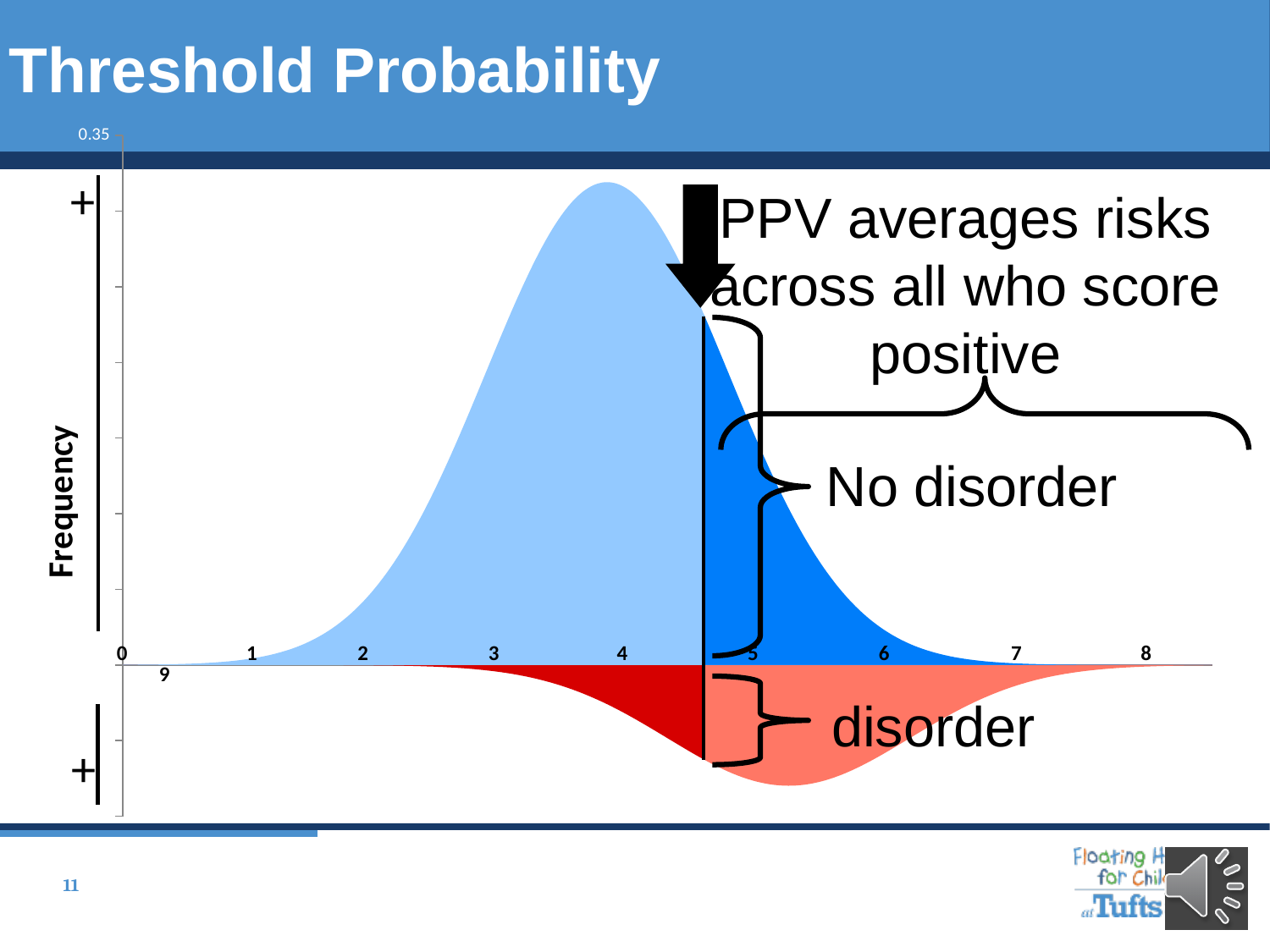
Is the peak of the disorder distribution at an x value greater or less than 5? greater Does the No disorder curve rise or fall as x goes from 1 to 4? rise Does the No disorder curve rise or fall as x goes from 5 to 8? fall Is the peak of the No disorder distribution at an x value greater or less than 3? greater What value is printed at the top of the vertical axis? 0.35 Which distribution peaks at a higher x value, No disorder or disorder? disorder What is the label on the vertical axis of the chart? Frequency Is the peak of the No disorder distribution at an x value greater or less than 5? less What is the title of the slide containing the chart? Threshold Probability Which group's distribution is plotted below the horizontal axis? disorder What kind of chart is shown on the slide? area chart